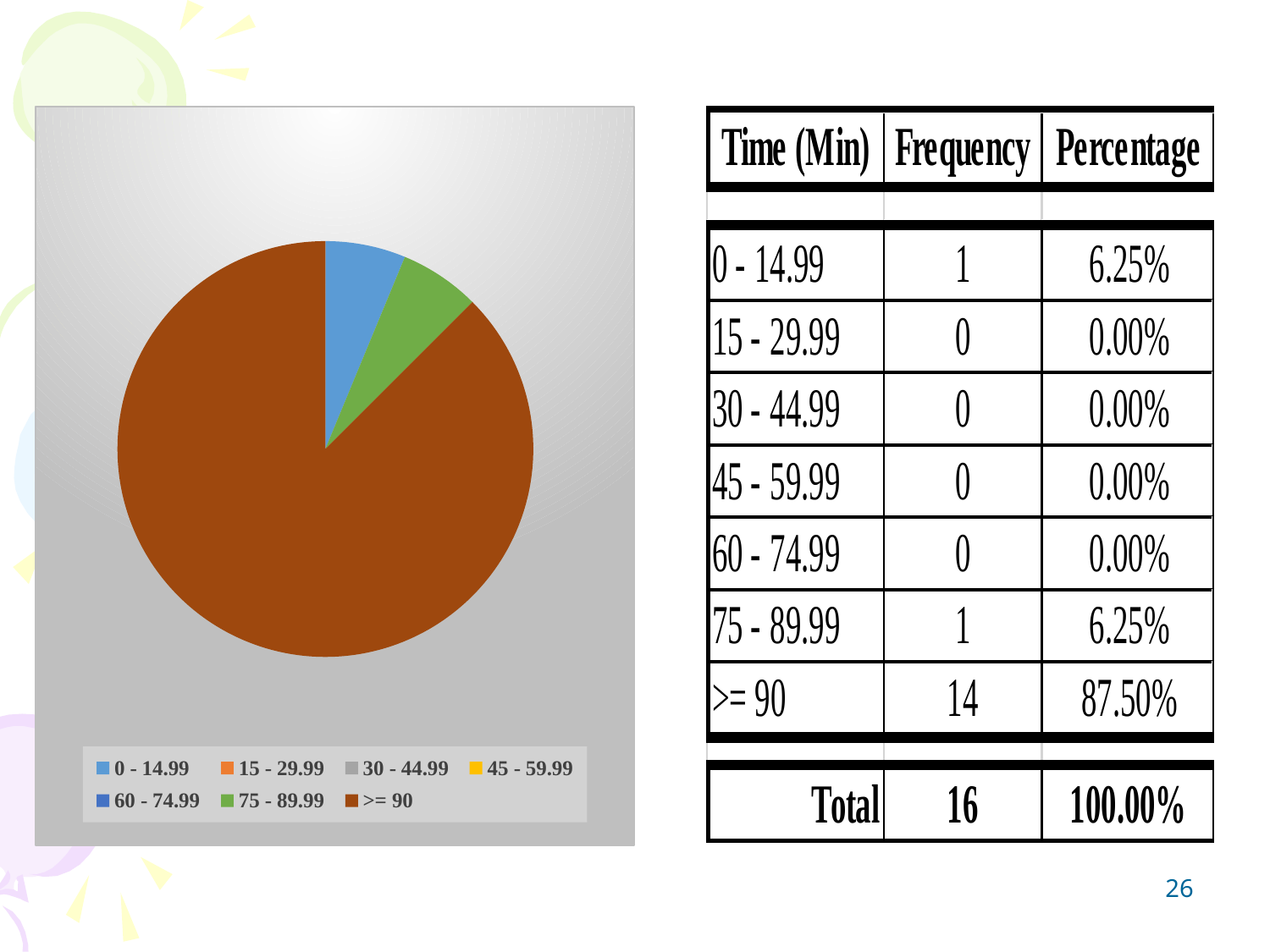
What colour is the largest slice of the pie chart? brown How many categories does the pie chart's legend list? 7 What is the frequency for the 0 - 14.99 category? 1 What is the difference in frequency between the >= 90 category and the 0 - 14.99 category? 13 What kind of chart is shown on the left of the slide? pie chart What share of the pie does the >= 90 category represent, according to the table on the slide? 87.50% What colour does the legend use for the 0 - 14.99 category? blue Which category has the largest slice of the pie chart? >= 90 Which is larger in the pie chart, the slice for >= 90 or the slice for 0 - 14.99? >= 90 How many categories have a visible slice in the pie chart? 3 What is the percentage for the 75 - 89.99 category? 6.25% What is the total frequency across all categories? 16